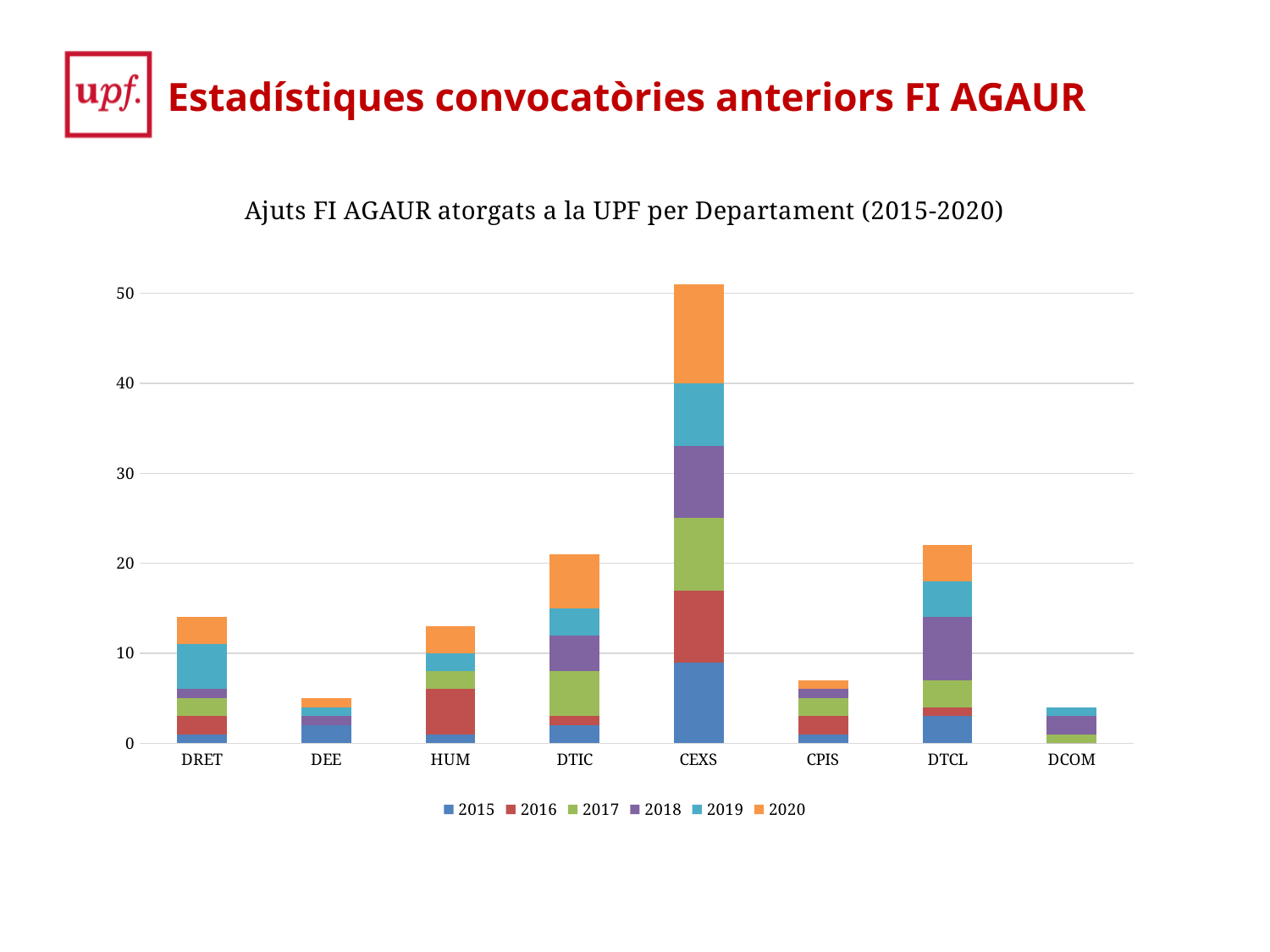
Which has the larger total stacked bar, DTIC or DRET? DTIC How many series does the legend list? 6 Is the total value for DCOM greater or less than 10? less Is the total value for CPIS greater or less than 10? less How many departments are shown on the x axis of the chart? 8 Is the total value for CEXS greater or less than 40? greater Which department has the highest total stacked bar? CEXS Which has the larger total stacked bar, CEXS or DTCL? CEXS What is the title of the chart? Ajuts FI AGAUR atorgats a la UPF per Departament (2015-2020) Which year does the orange colour represent in the legend? 2020 What kind of chart is shown on the slide? stacked bar chart